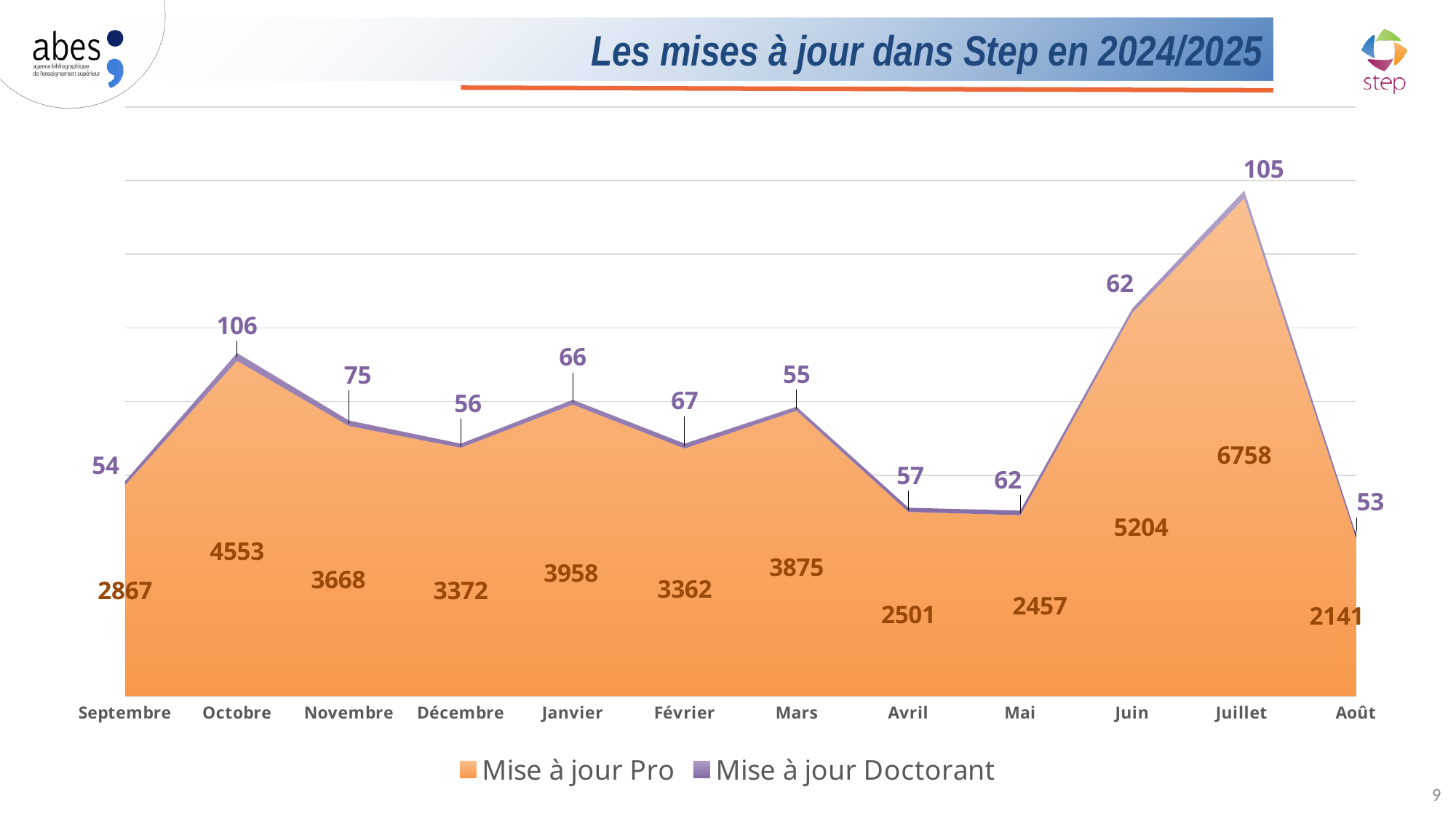
What is the value of Mise à jour Pro for Mai? 2457 How many series does the legend list? 2 Which month has the lowest value for Mise à jour Doctorant? Août What is the value of Mise à jour Doctorant for Octobre? 106 What kind of chart is shown on the slide? Area chart What is the difference between the Mise à jour Pro values for Juillet and Août? 4617 Which month has the lowest value for Mise à jour Pro? Août Which month has the highest value for Mise à jour Pro? Juillet What is the title of the chart? Les mises à jour dans Step en 2024/2025 How many months are shown on the x axis? 12 Which is larger, the Mise à jour Pro value for Octobre or for Juin? Juin What is the value of Mise à jour Pro for Juillet? 6758